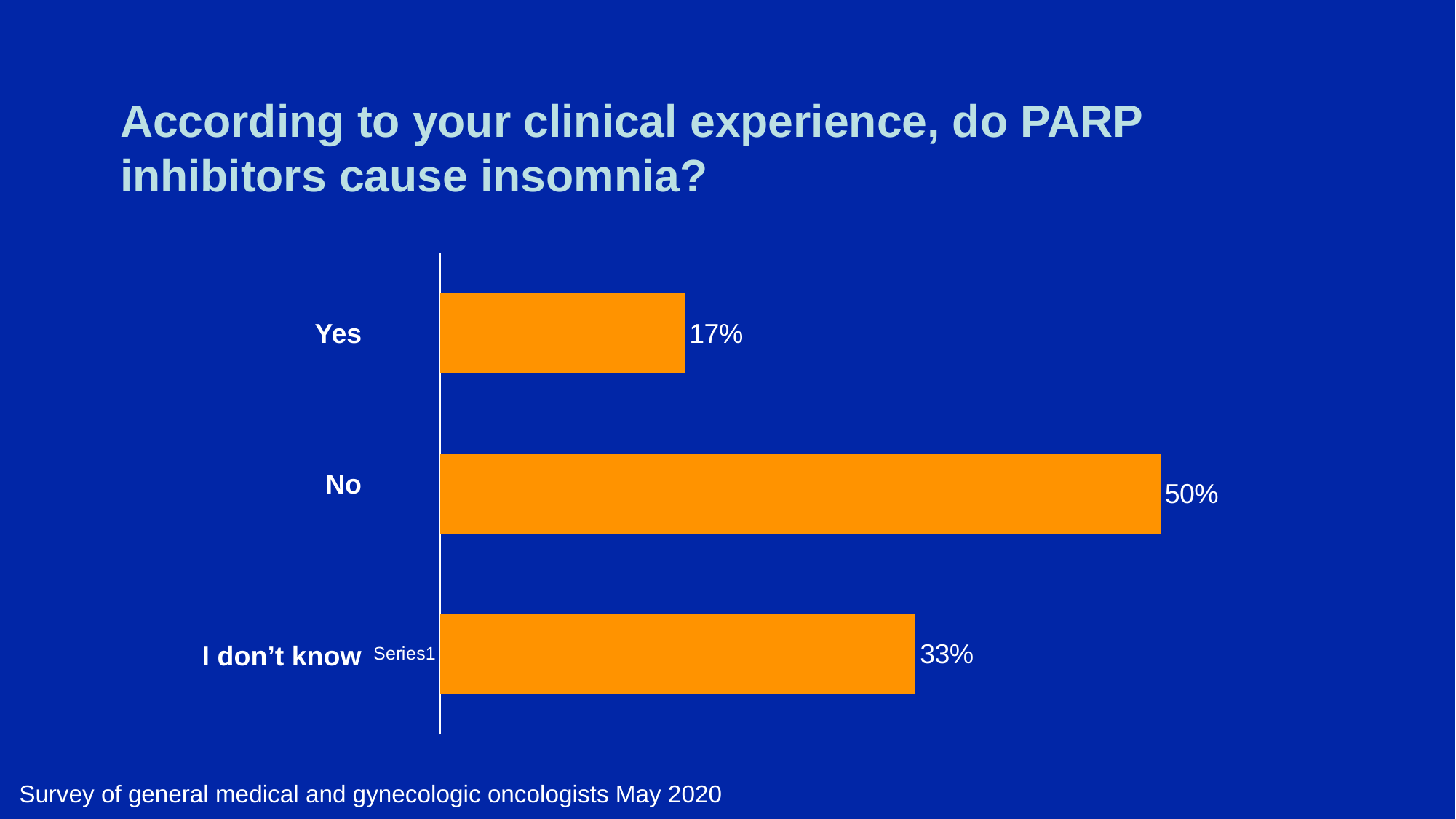
What percentage of respondents answered "No"? 50% What colour are the bars in the chart? Orange Which response category has the lowest percentage? Yes What percentage of respondents answered "I don't know"? 33% What is the source note shown at the bottom of the slide? Survey of general medical and gynecologic oncologists May 2020 How many response categories are shown in the chart? 3 What percentage of respondents answered "Yes"? 17% Which response category has the highest percentage? No What is the difference in percentage points between the "I don't know" and "Yes" responses? 16 What kind of chart is shown on the slide? Bar chart Which is larger, the percentage for "I don't know" or the percentage for "Yes"? I don't know What is the difference in percentage points between the "No" and "Yes" responses? 33